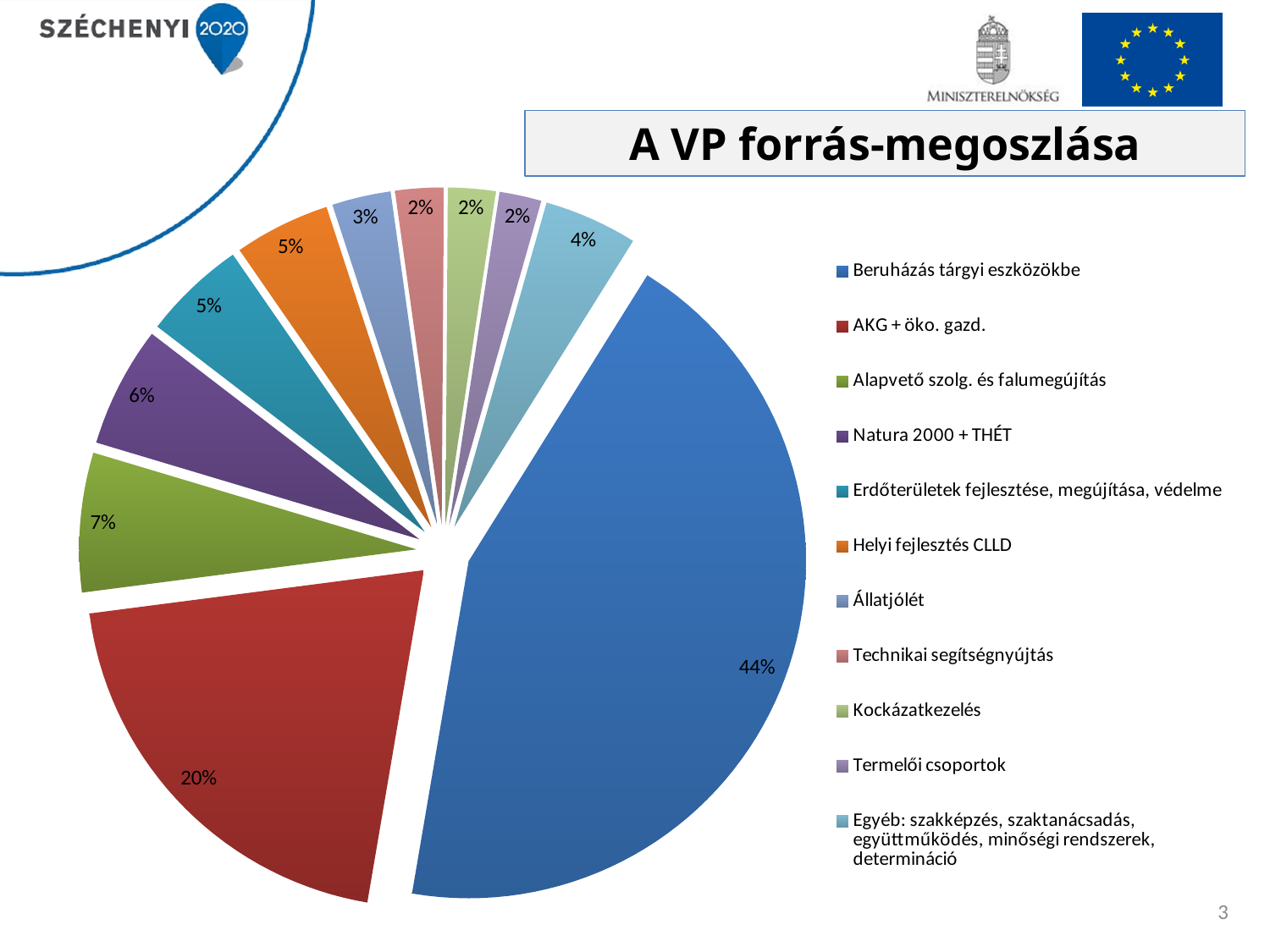
What share of the pie does 'Beruházás tárgyi eszközökbe' take? 44% What is the difference in percentage points between 'Beruházás tárgyi eszközökbe' and 'AKG + öko. gazd.'? 24 What is the title of the chart? A VP forrás-megoszlása What colour is the slice for 'Helyi fejlesztés CLLD'? orange What percentage is shown for 'Állatjólét'? 3% How many slices does the pie chart have? 11 What percentage is shown for 'Natura 2000 + THÉT'? 6% What type of chart is shown on the slide? pie chart Which has a larger share: 'Alapvető szolg. és falumegújítás' or 'Helyi fejlesztés CLLD'? Alapvető szolg. és falumegújítás What percentage is shown for 'Alapvető szolg. és falumegújítás'? 7% Which category has the largest share of the pie? Beruházás tárgyi eszközökbe What percentage is shown for 'AKG + öko. gazd.'? 20%